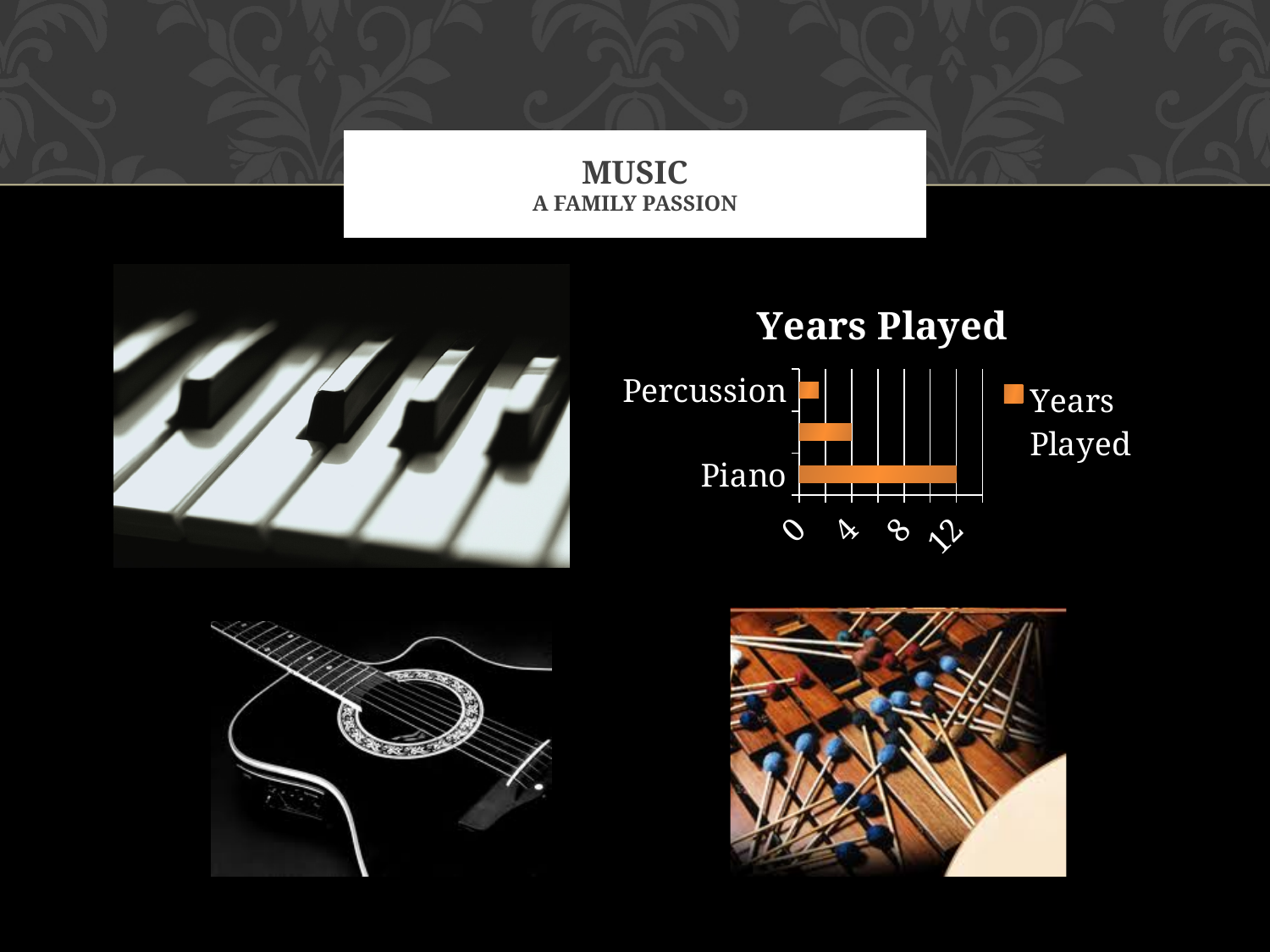
How many series does the legend of the Years Played chart list? 1 In the Years Played chart, is the value for Percussion greater or less than 4? less What kind of chart is shown on the slide? bar chart What is the title of the chart on the slide? Years Played What is the name of the series shown in the legend of the Years Played chart? Years Played In the Years Played chart, which has the larger value, Piano or Percussion? Piano How many bars are plotted in the Years Played chart? 3 Which instrument has the lowest value in the Years Played chart? Percussion Which instrument has the highest value in the Years Played chart? Piano In the Years Played chart, is the value for Piano greater or less than 8? greater